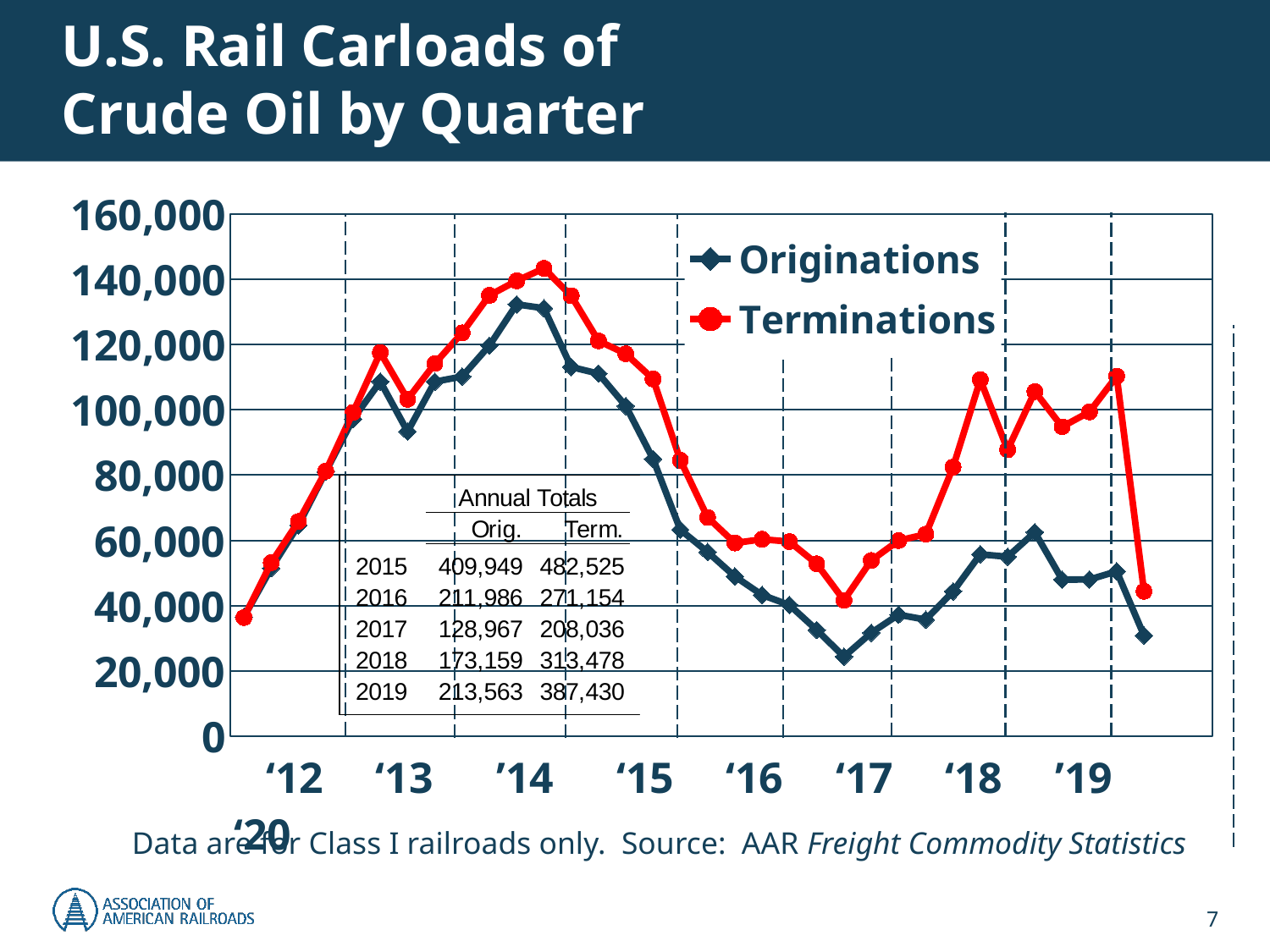
From 2014 to 2017, do Originations rise or fall? Fall According to the Annual Totals table, which year had the lowest Originations total? 2017 In 2018, which series is higher, Originations or Terminations? Terminations Is the final plotted value for Originations (in 2020) greater or less than 40,000? less According to the Annual Totals table, what was the Originations total for 2015? 409,949 According to the Annual Totals table, what was the Terminations total for 2019? 387,430 Is the peak value of Originations in 2014 greater or less than 120,000? greater How many series does the legend list? 2 What is the title of the chart? U.S. Rail Carloads of Crude Oil by Quarter What kind of chart is shown on the slide? Line chart In which year do Terminations reach their highest point? '14 What are the two series named in the legend? Originations and Terminations